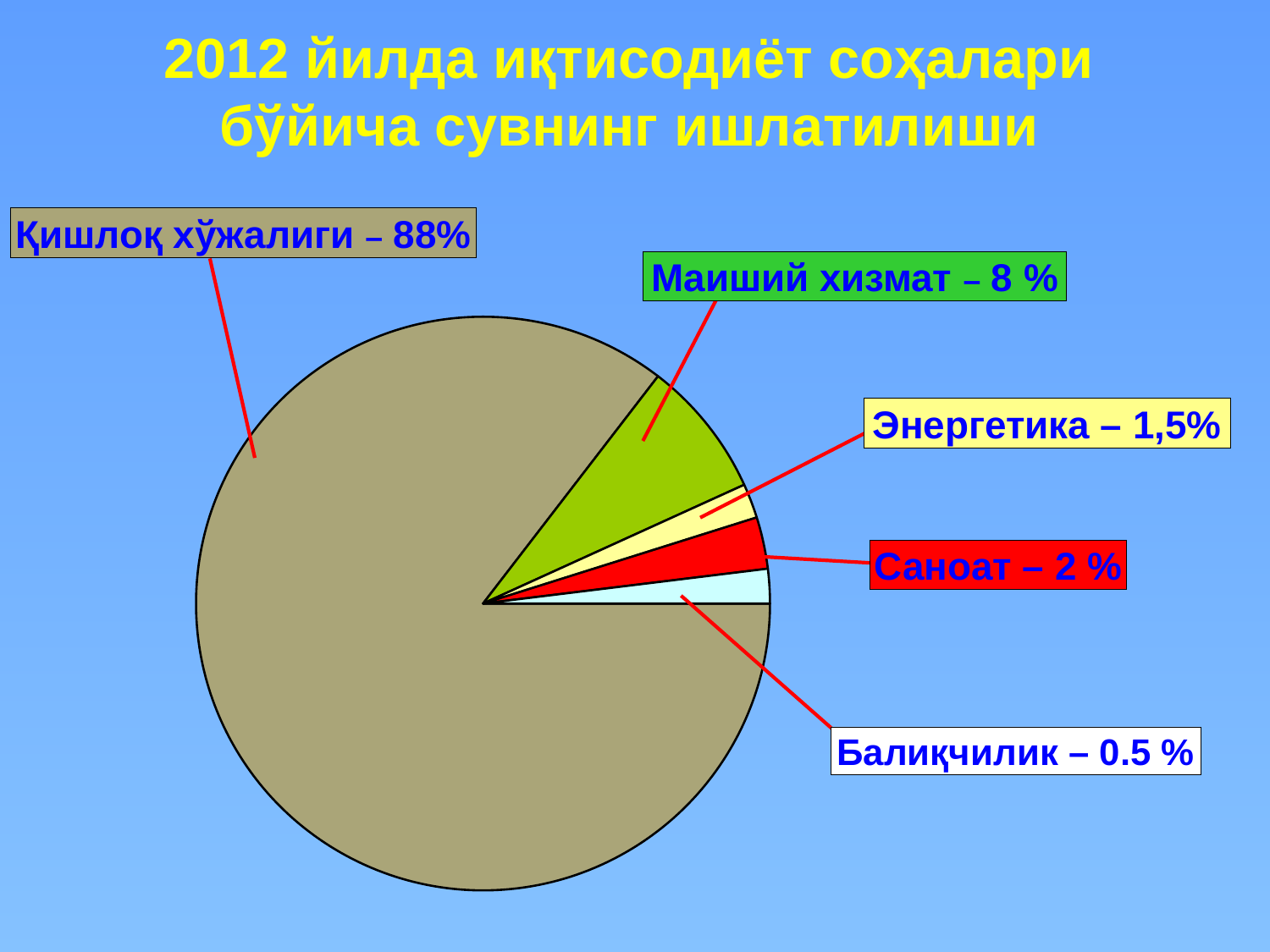
What is the difference between the share for Қишлоқ хўжалиги and the share for Маиший хизмат? 80% What share of water use is attributed to Маиший хизмат? 8 % What share of water use is attributed to Саноат? 2 % What share of water use is attributed to Энергетика? 1,5% How many sectors (slices) are shown in the pie chart? 5 Which sector has the smallest share of the pie? Балиқчилик What is the title of the slide containing the pie chart? 2012 йилда иқтисодиёт соҳалари бўйича сувнинг ишлатилиши Which sector has the largest share of the pie? Қишлоқ хўжалиги What share of water use is attributed to Балиқчилик? 0.5 % What kind of chart is shown on the slide? pie chart What share of water use is attributed to Қишлоқ хўжалиги? 88% Which is larger, the share for Саноат or the share for Энергетика? Саноат